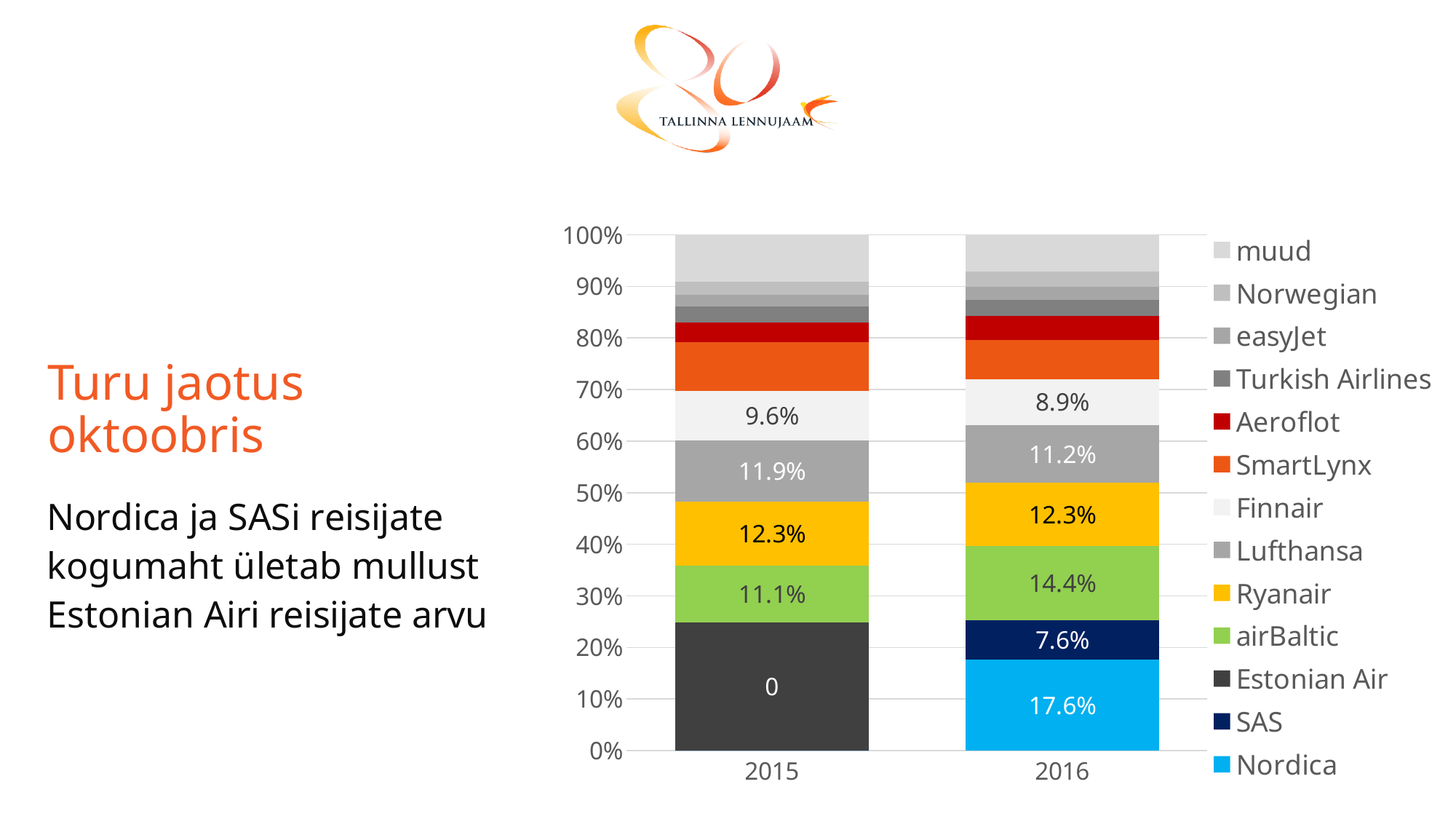
By how many percentage points did airBaltic's share change from 2015 to 2016? 3.3 percentage points What is the value for Finnair in 2016? 8.9% Was Lufthansa's share larger in 2015 or in 2016? 2015 What kind of chart is shown on the slide? Stacked bar chart How many years (categories) are shown on the x axis? 2 How many series does the legend list? 13 What is the value for SAS in 2016? 7.6% What is the combined share of Nordica and SAS in 2016? 25.2% What is the value for Nordica in 2016? 17.6% Did Finnair's share rise or fall from 2015 to 2016? Fall What is the value for airBaltic in 2015? 11.1% Is the value for muud in 2016 greater or less than 10%? less